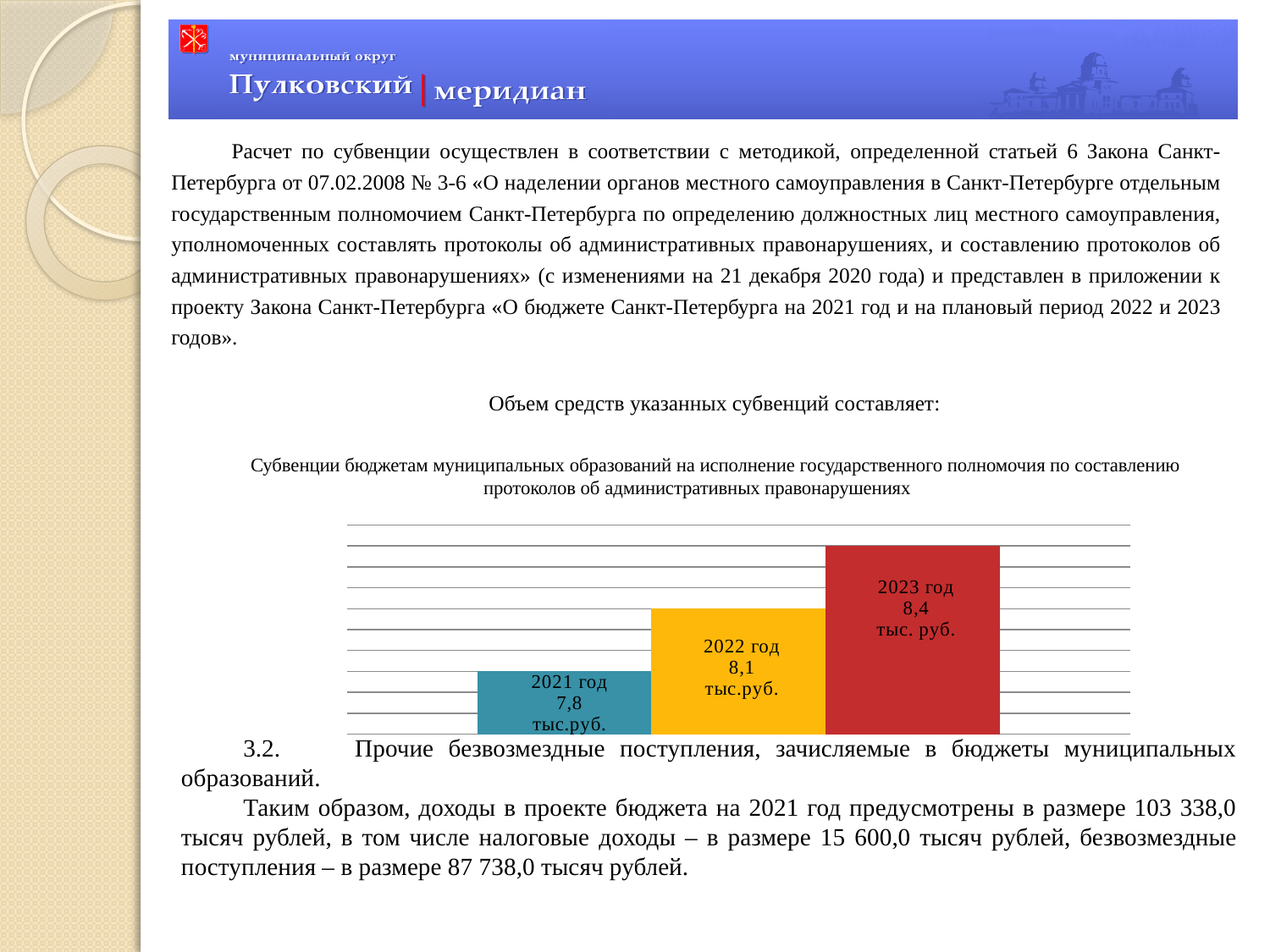
Which year has the lowest value in the chart? 2021 год What colour is the bar for 2023 год? Red What type of chart is shown on the slide? Bar chart Which is larger, the value for 2022 год or the value for 2023 год? 2023 год What is the difference between the values for 2023 год and 2021 год? 0,6 тыс. руб. Do the values rise or fall from 2021 год to 2023 год? Rise Which year has the highest value in the chart? 2023 год What is the difference between the values for 2022 год and 2021 год? 0,3 тыс. руб. What is the value shown for 2021 год? 7,8 тыс.руб. What is the value shown for 2022 год? 8,1 тыс.руб. What is the value shown for 2023 год? 8,4 тыс. руб. How many bars are shown in the chart? 3